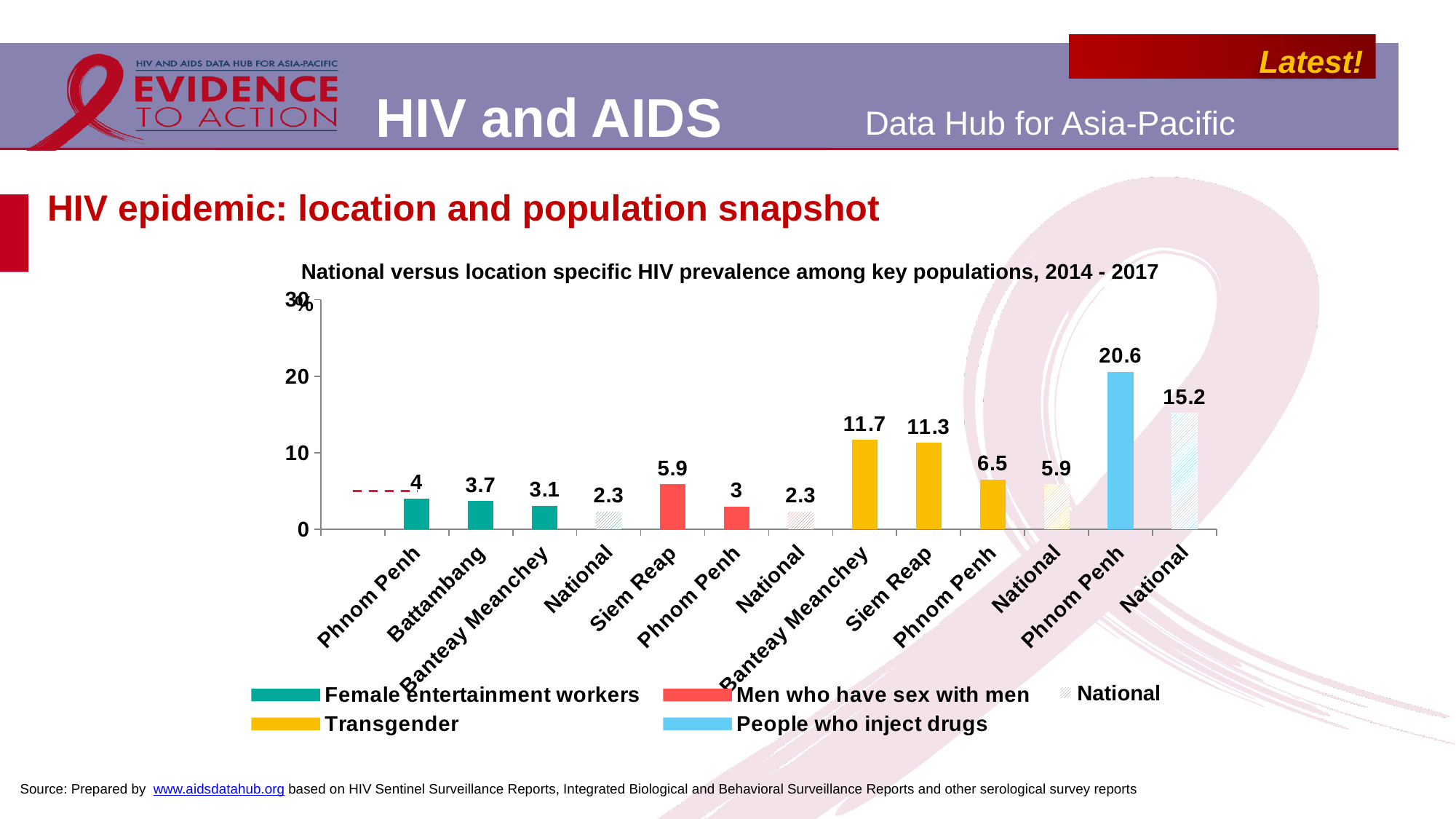
Which bar has the highest value in the chart? Phnom Penh (People who inject drugs) What is the HIV prevalence among female entertainment workers in Battambang? 3.7 What is the HIV prevalence among men who have sex with men in Siem Reap? 5.9 How many series does the legend list? 5 What type of chart is shown on the slide? Bar chart Which is larger: the Siem Reap value for men who have sex with men or the Phnom Penh value for female entertainment workers? Siem Reap (men who have sex with men) What is the difference between the Banteay Meanchey and Phnom Penh values for transgender people? 5.2 Which location has the highest HIV prevalence among transgender people? Banteay Meanchey What is the HIV prevalence among people who inject drugs in Phnom Penh? 20.6 How many bars are plotted in the chart? 13 What is the national HIV prevalence among transgender people? 5.9 What is the difference between the Phnom Penh and national values for people who inject drugs? 5.4